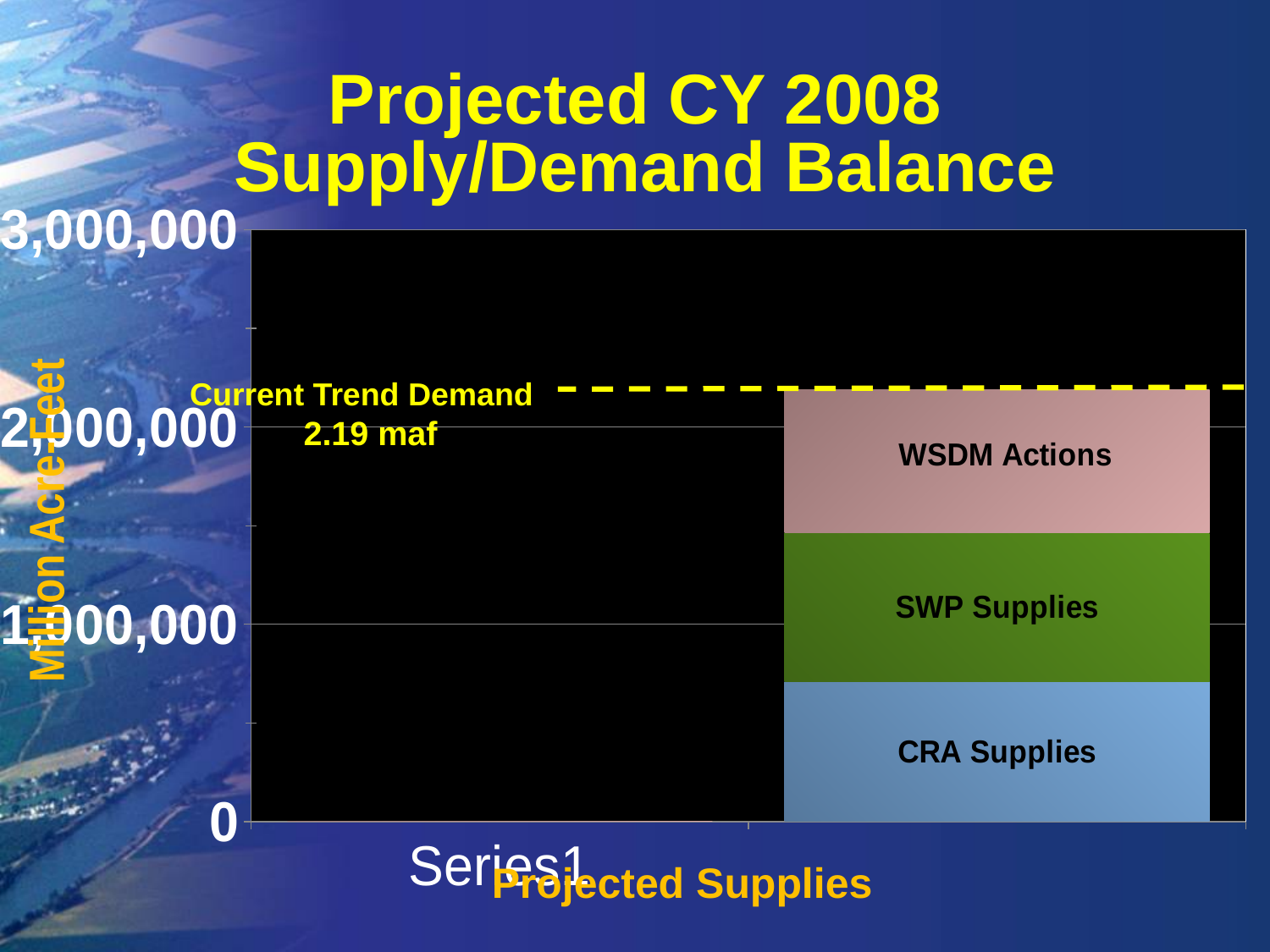
What value is given for the Current Trend Demand line? 2.19 maf How many bars are plotted in the chart? 1 What is the highest value shown on the y axis? 3,000,000 What is the label on the y axis? Million Acre-Feet Which segment is at the bottom of the stacked bar? CRA Supplies How many labelled segments make up the stacked bar? 3 What kind of chart is shown on the slide? bar chart Is the top of the stacked bar greater or less than 3,000,000? less Is the top of the CRA Supplies segment greater or less than 1,000,000? less Is the top of the SWP Supplies segment greater or less than 1,000,000? greater